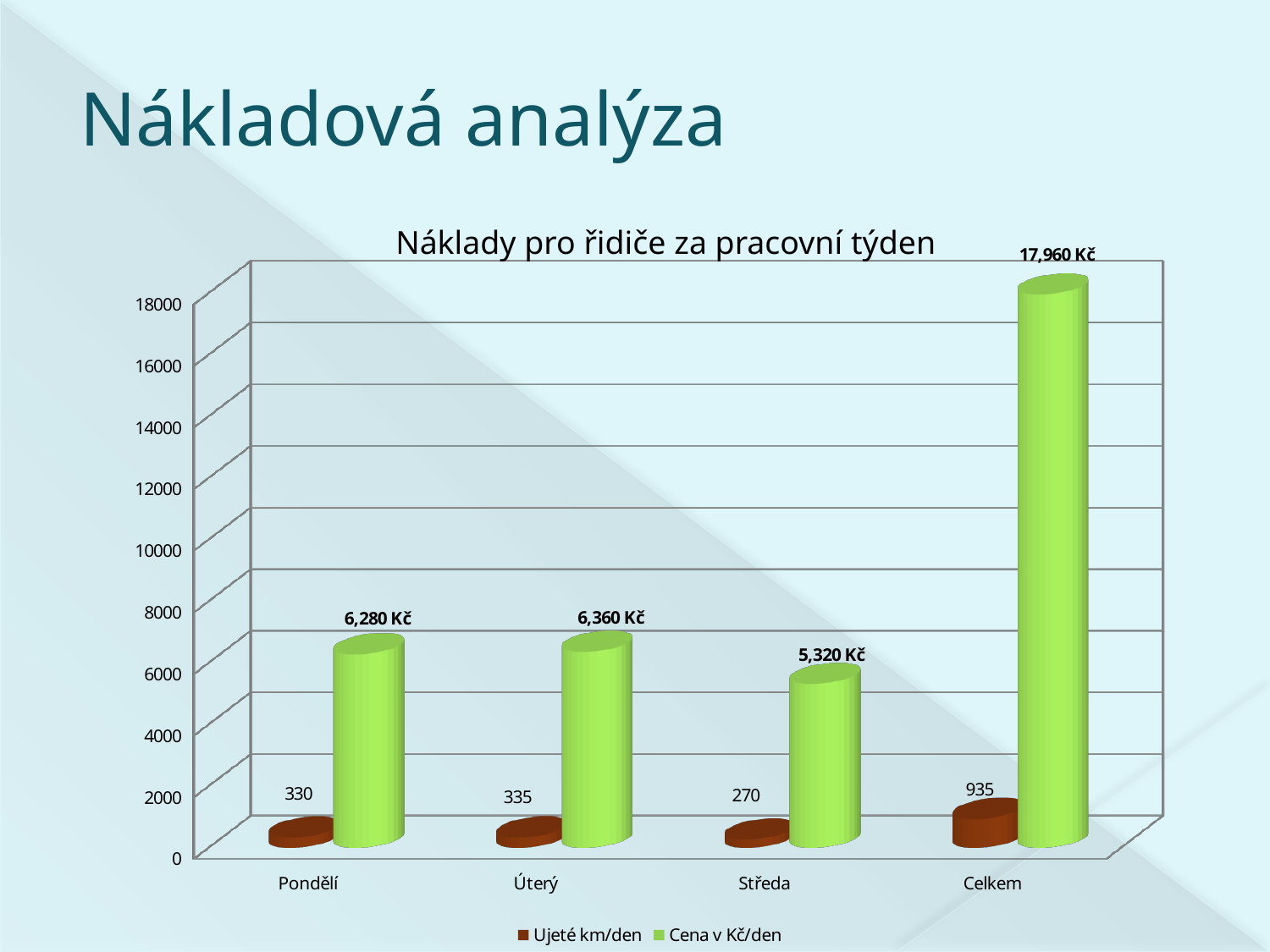
How many series does the legend list? 2 Among Pondělí, Úterý and Středa, which has the lowest Cena v Kč/den value? Středa What is the value of Ujeté km/den for Středa? 270 Which is larger, the Ujeté km/den value for Pondělí or for Úterý? Úterý What is the title of the chart? Náklady pro řidiče za pracovní týden What is the value of Cena v Kč/den for Celkem? 17,960 Kč Which category has the highest Cena v Kč/den value? Celkem What is the value of Cena v Kč/den for Pondělí? 6,280 Kč Is the Cena v Kč/den value for Celkem greater or less than 16000? greater What is the value of Ujeté km/den for Úterý? 335 How many categories are shown on the x axis? 4 What is the difference between the Cena v Kč/den values for Úterý and Pondělí? 80 Kč